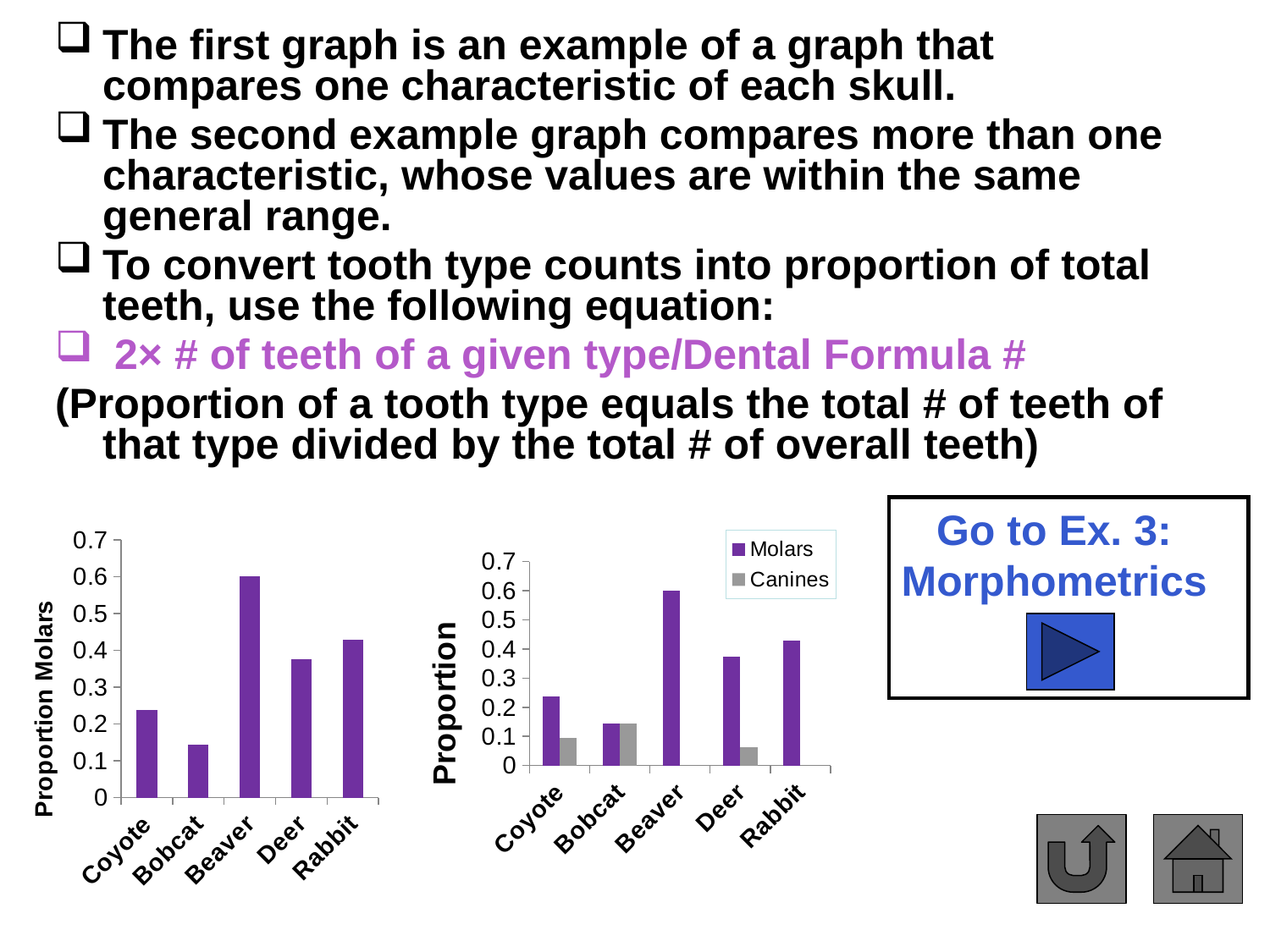
In the left chart, is the value for Coyote greater or less than 0.3? less In the left chart, which is larger, the value for Coyote or the value for Bobcat? Coyote How many animal categories are shown on the x axis of the left chart? 5 In the left chart, is the value for Deer greater or less than 0.3? greater What kind of chart is the left chart (y-axis 'Proportion Molars')? bar chart In the left chart, which animal has the highest proportion of molars? Beaver In the left chart, which animal has the lowest proportion of molars? Bobcat In the right chart, is the Molars value for Beaver greater or less than 0.5? greater In the right chart, which animal has the highest Canines value? Bobcat What are the two series named in the legend of the right chart? Molars and Canines How many series does the legend of the right chart list? 2 What is the y-axis title of the left chart? Proportion Molars